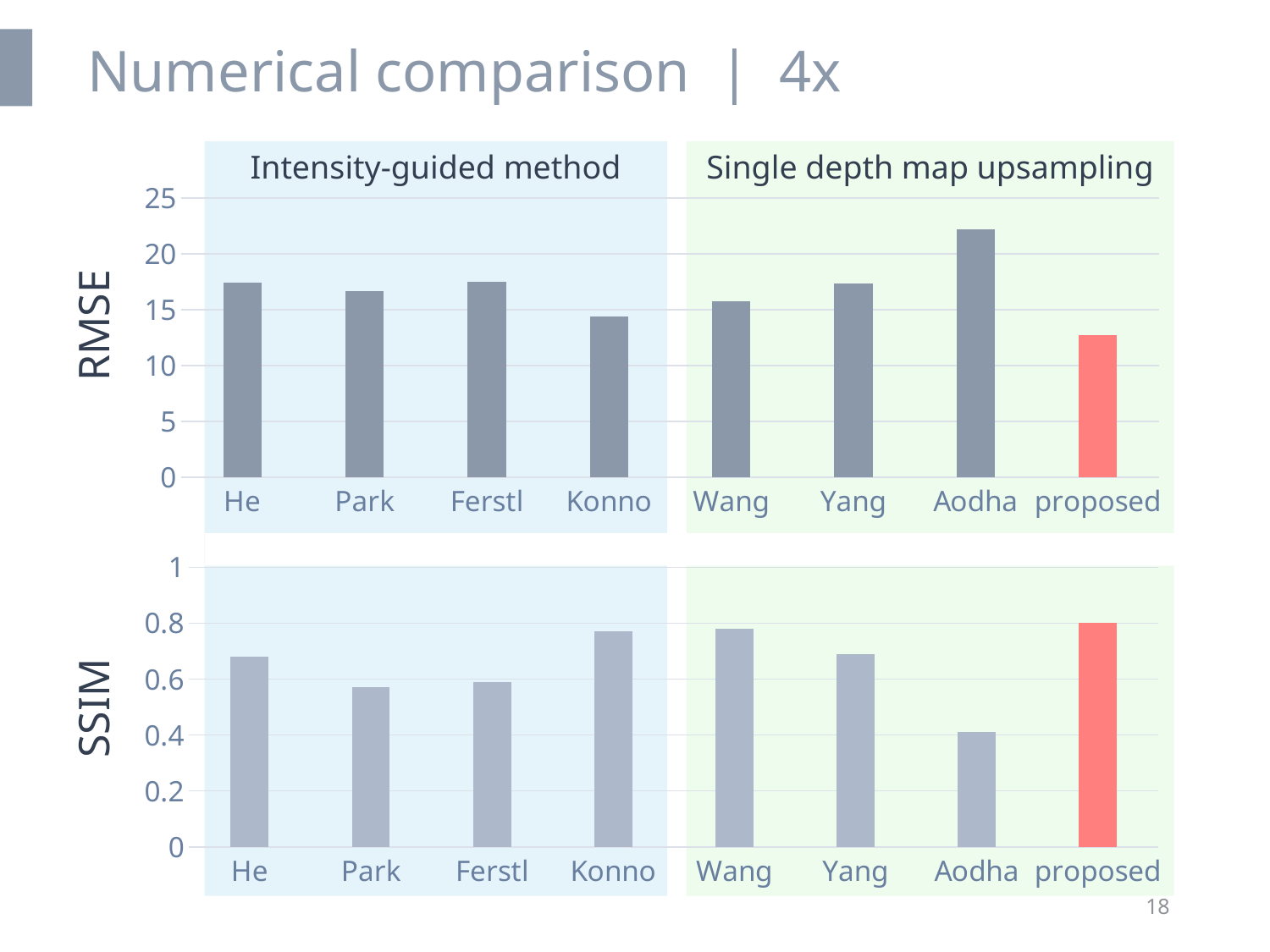
In the SSIM chart, which method has the lowest SSIM? Aodha What kind of chart is the SSIM chart? bar chart In the SSIM chart, which has the larger SSIM, Konno or Park? Konno In the RMSE chart, which method has the highest RMSE? Aodha In the RMSE chart, which method's bar is highlighted in red? proposed How many methods are compared in the RMSE chart? 8 In the RMSE chart, which method has the lowest RMSE? proposed In the SSIM chart, is the value for Konno greater or less than 0.6? greater In the RMSE chart, is the value for Aodha greater or less than 20? greater In the SSIM chart, is the value for Aodha greater or less than 0.6? less In the RMSE chart, which has the larger RMSE, Aodha or Konno? Aodha